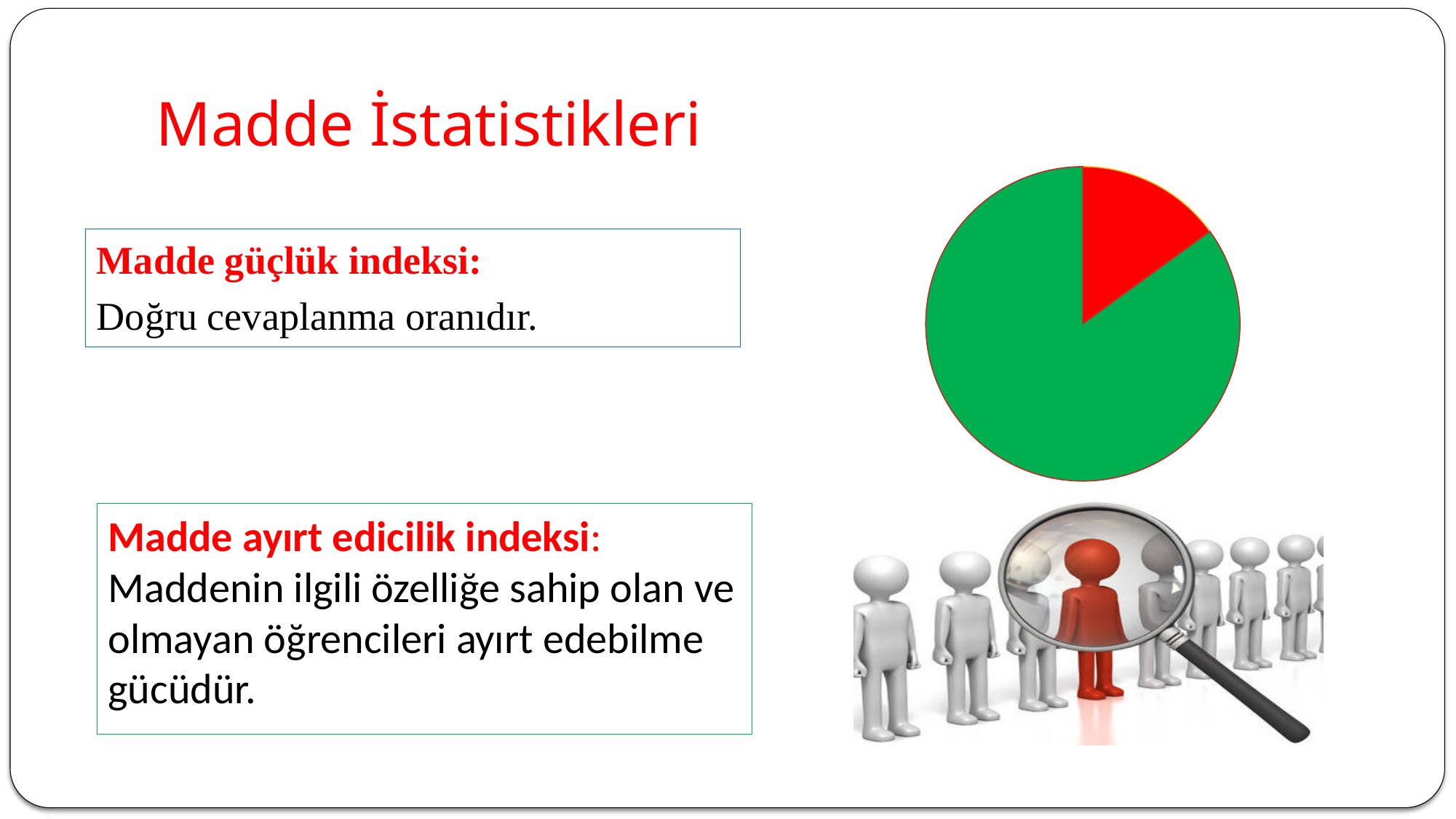
Which colour slice takes up the smallest share of the pie chart? red How many slices does the pie chart have? 2 What two colours are used for the slices of the pie chart? green and red Which colour slice takes up the largest share of the pie chart? green What kind of chart is shown on the slide? pie chart Which slice of the pie chart is larger, the green one or the red one? green Does the pie chart display a legend? No